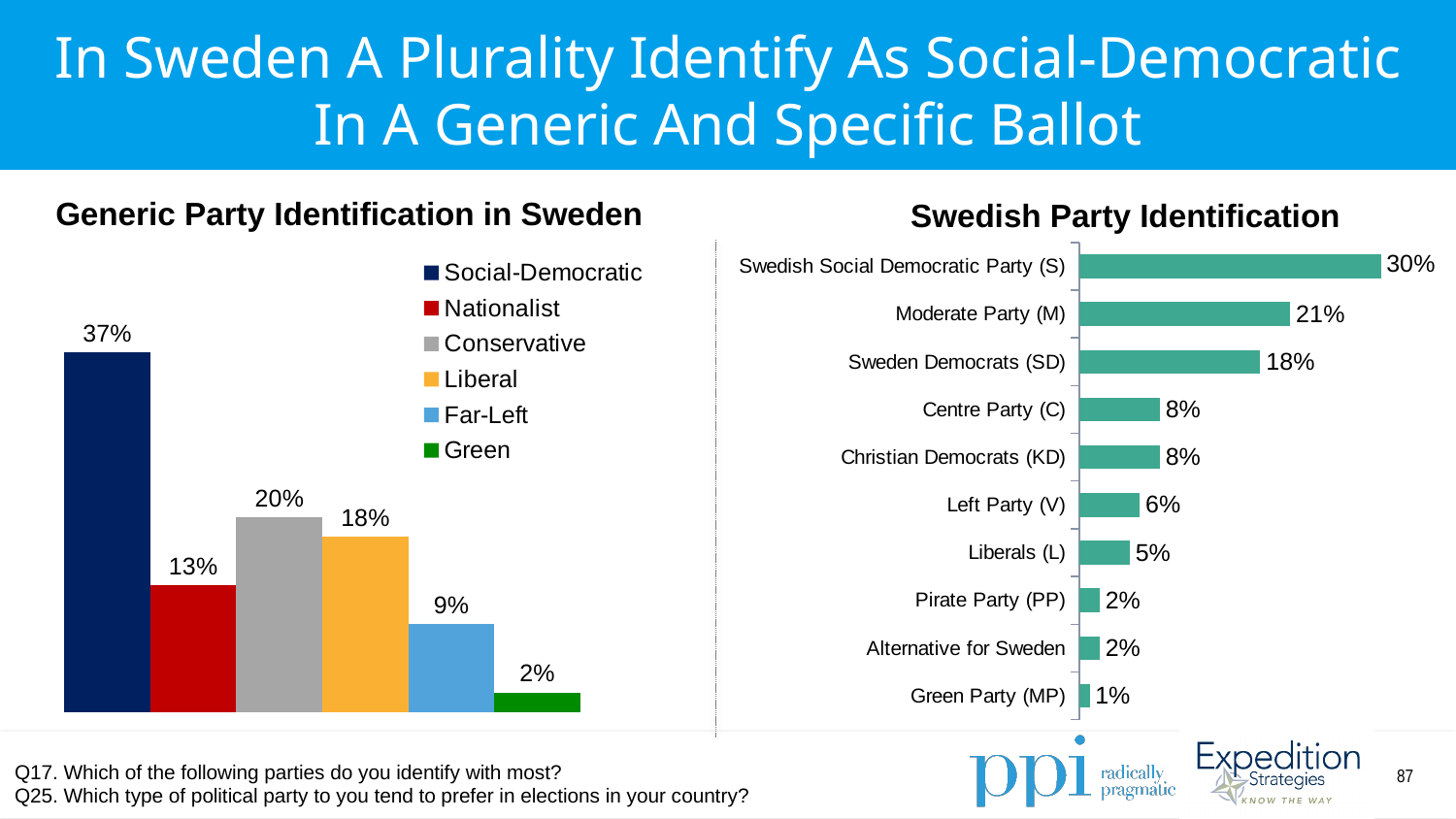
In the 'Generic Party Identification in Sweden' chart, what is the difference between Conservative and Nationalist? 7% In the 'Generic Party Identification in Sweden' chart, what is the value for Social-Democratic? 37% In the 'Generic Party Identification in Sweden' chart, how many series does the legend list? 6 In the 'Swedish Party Identification' chart, which category has the highest value? Swedish Social Democratic Party (S) In the 'Swedish Party Identification' chart, which is larger: Sweden Democrats (SD) or Liberals (L)? Sweden Democrats (SD) In the 'Generic Party Identification in Sweden' chart, which category has the lowest value? Green In the 'Swedish Party Identification' chart, what is the value for Moderate Party (M)? 21% In the 'Swedish Party Identification' chart, how many categories are shown? 10 In the 'Generic Party Identification in Sweden' chart, what colour is the Far-Left bar? Light blue In the 'Generic Party Identification in Sweden' chart, what is the value for Liberal? 18% What kind of chart is the 'Swedish Party Identification' chart? Bar chart In the 'Swedish Party Identification' chart, what is the value for Left Party (V)? 6%